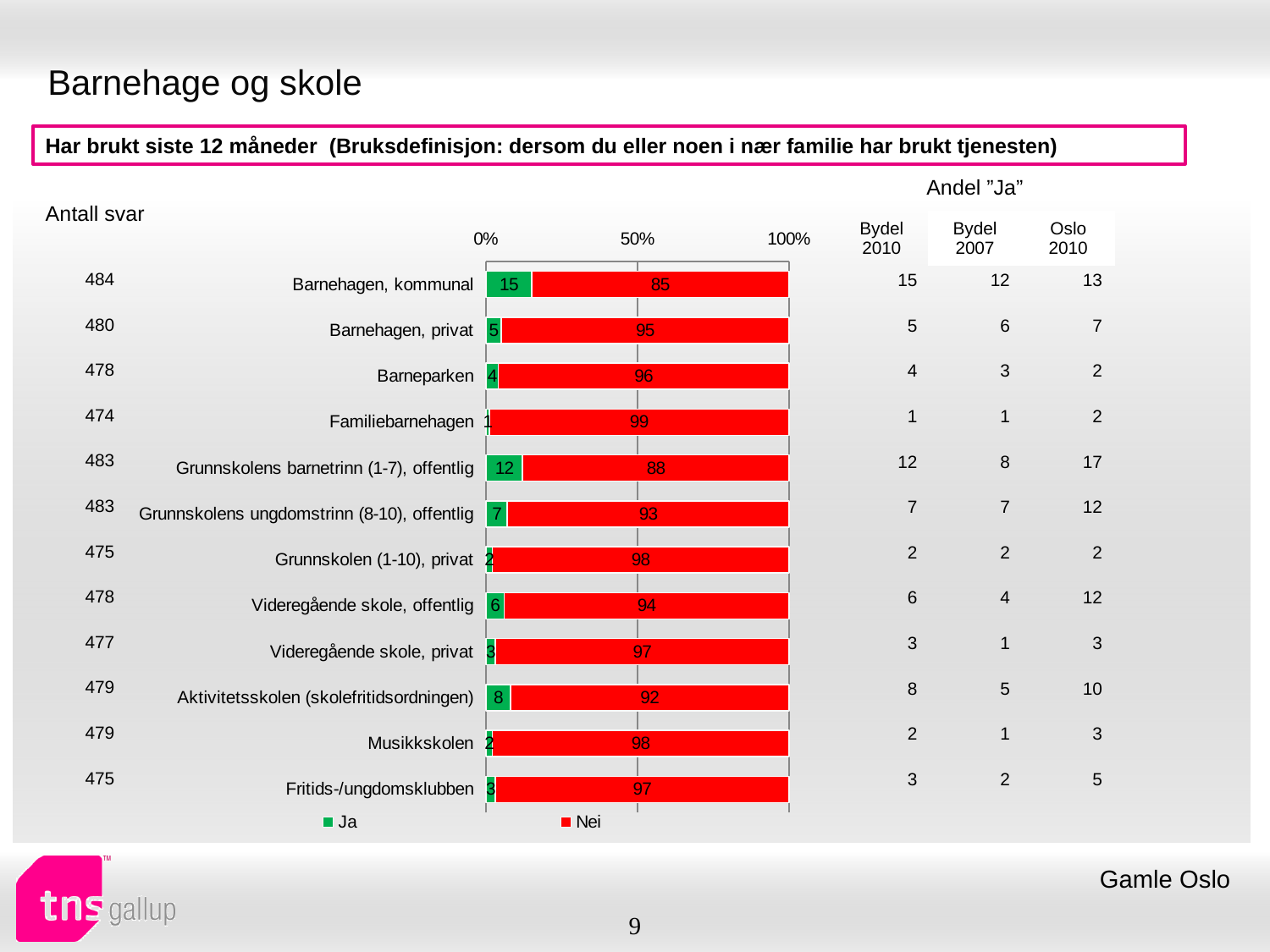
What is the "Nei" value for Familiebarnehagen? 99 Which has a larger "Ja" value: Grunnskolens barnetrinn (1-7), offentlig or Videregående skole, offentlig? Grunnskolens barnetrinn (1-7), offentlig What is the difference between the "Nei" values for Barnehagen, privat and Barnehagen, kommunal? 10 What is the "Ja" value for Barnehagen, kommunal? 15 Which colour represents the "Nei" series in the chart? red What is the "Ja" value for Aktivitetsskolen (skolefritidsordningen)? 8 How many categories are plotted in the chart? 12 What is the total of the stacked bar for Musikkskolen? 100 How many series does the chart legend list? 2 What kind of chart is shown on the slide? stacked bar chart Which category has the lowest "Ja" value? Familiebarnehagen Which category has the highest "Ja" value? Barnehagen, kommunal